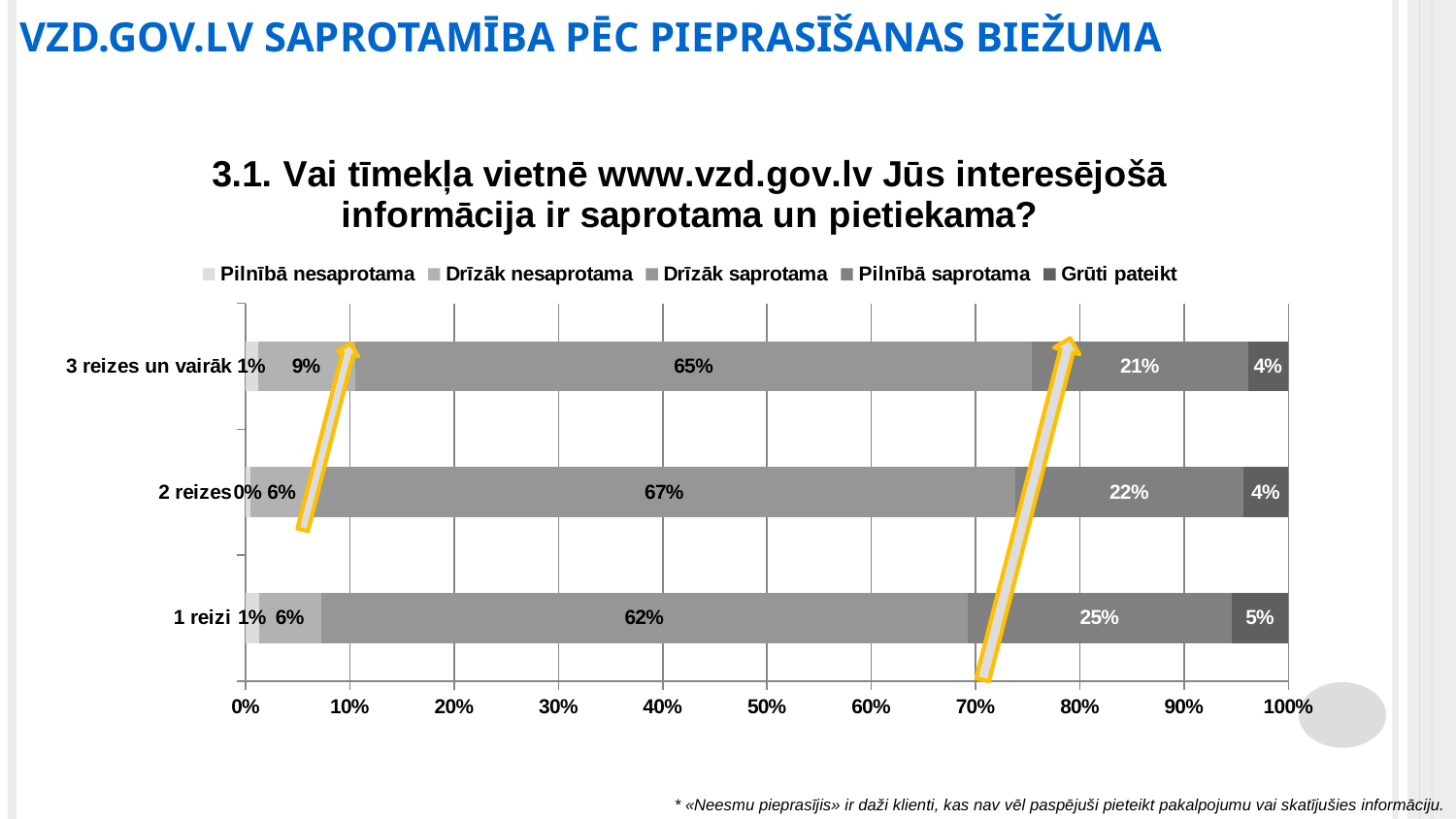
What is the value of 'Drīzāk nesaprotama' for '3 reizes un vairāk'? 9% What is the first series listed in the legend? Pilnībā nesaprotama How many series does the legend list? 5 What kind of chart is shown on the slide? Stacked bar chart What is the value of 'Pilnībā saprotama' for '1 reizi'? 25% Which is larger: 'Drīzāk nesaprotama' for '3 reizes un vairāk' or for '2 reizes'? 3 reizes un vairāk How many categories are plotted on the vertical axis? 3 What is the value of 'Grūti pateikt' for '1 reizi'? 5% What is the value of 'Drīzāk saprotama' for '2 reizes'? 67% Which category has the highest value for 'Drīzāk saprotama'? 2 reizes What is the difference between the 'Drīzāk saprotama' values for '2 reizes' and '1 reizi'? 5% Which category has the lowest value for 'Pilnībā saprotama'? 3 reizes un vairāk